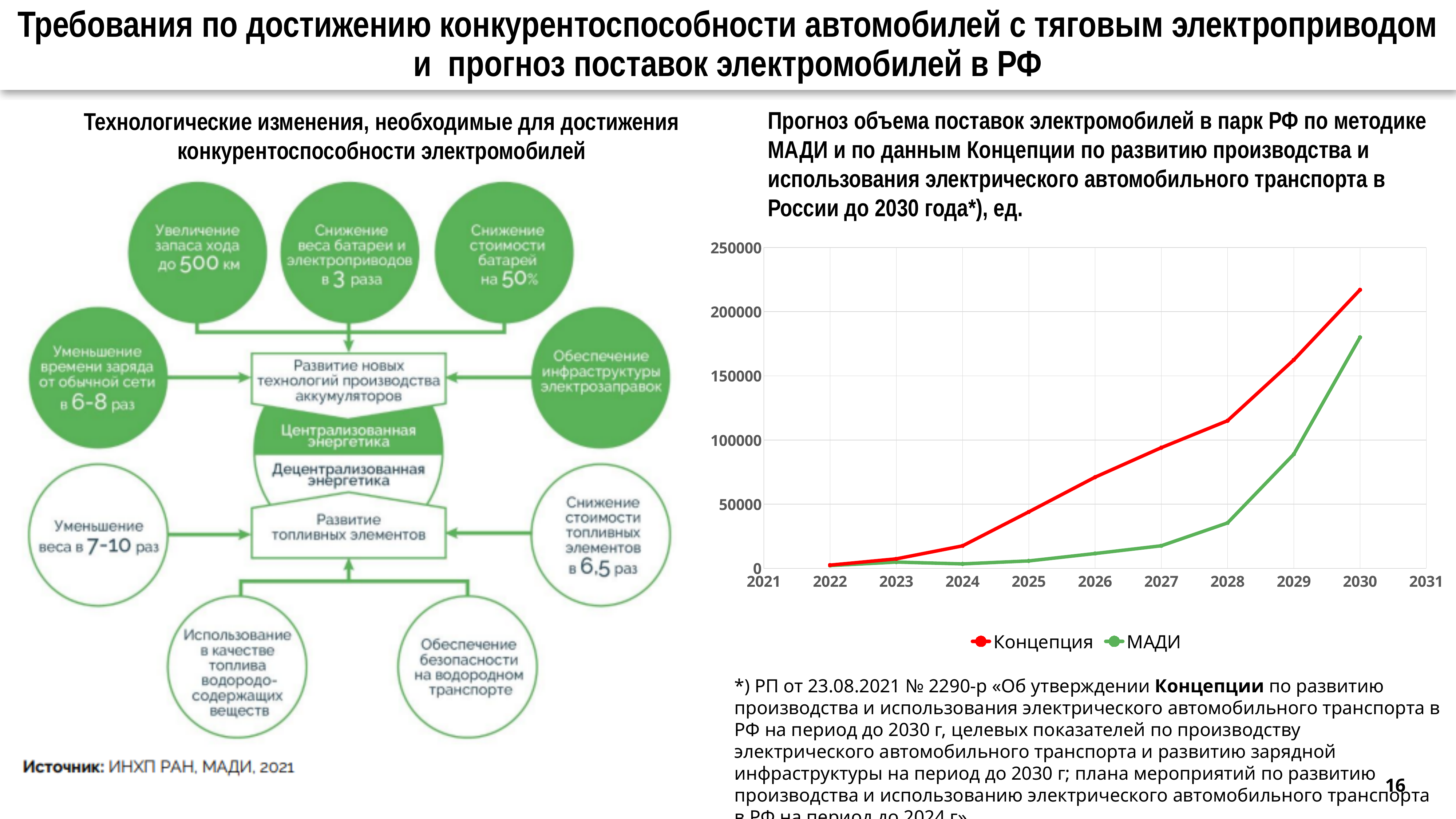
How many series does the legend of the line chart list? 2 In the line chart, do the values of the Концепция series rise or fall from 2022 to 2030? rise In the line chart, is the value for МАДИ in 2029 greater or less than 100000? less In the line chart, which series has the larger value in 2030, Концепция or МАДИ? Концепция In the line chart, is the value for МАДИ in 2030 greater or less than 200000? less What are the two series named in the legend of the line chart? Концепция and МАДИ In the line chart, is the value for Концепция in 2030 greater or less than 200000? greater In the line chart, in which year does the Концепция series reach its highest value? 2030 What kind of chart is shown on the right side of the slide? line chart In the line chart, which colour is used for the МАДИ series? green